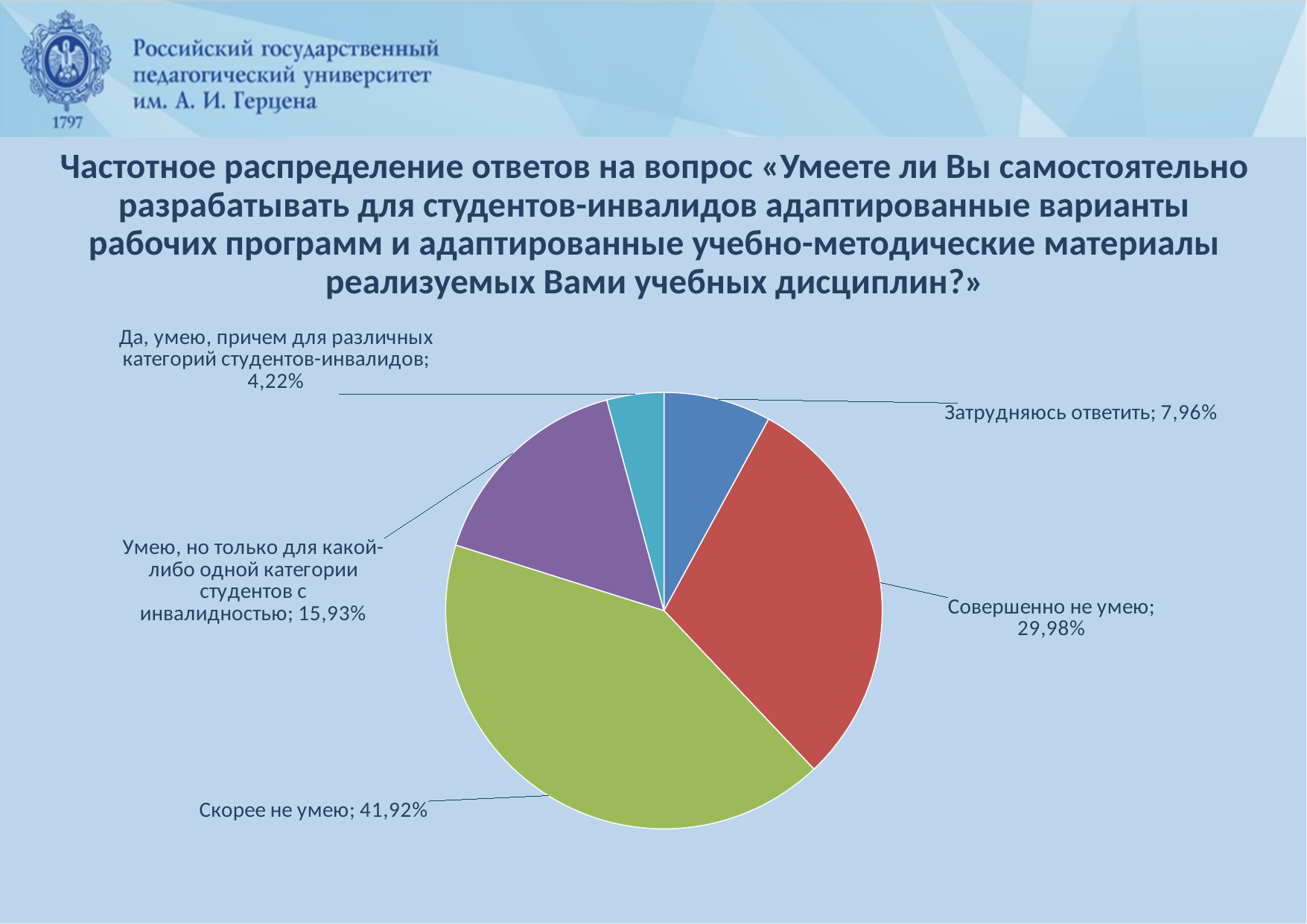
What share of respondents answered «Совершенно не умею»? 29,98% What share of respondents answered «Затрудняюсь ответить»? 7,96% What share of respondents answered «Да, умею, причем для различных категорий студентов-инвалидов»? 4,22% How many answer options (slices) does the pie chart show? 5 Which is larger: the share for «Затрудняюсь ответить» or the share for «Умею, но только для какой-либо одной категории студентов с инвалидностью»? Умею, но только для какой-либо одной категории студентов с инвалидностью What is the difference in percentage points between «Умею, но только для какой-либо одной категории студентов с инвалидностью» and «Да, умею, причем для различных категорий студентов-инвалидов»? 11,71% Which answer option has the largest share of the pie? Скорее не умею What share of respondents answered «Скорее не умею»? 41,92% What colour is the slice for «Скорее не умею»? Green What is the difference in percentage points between «Скорее не умею» and «Совершенно не умею»? 11,94% What type of chart is shown on the slide? Pie chart Which answer option has the smallest share of the pie? Да, умею, причем для различных категорий студентов-инвалидов